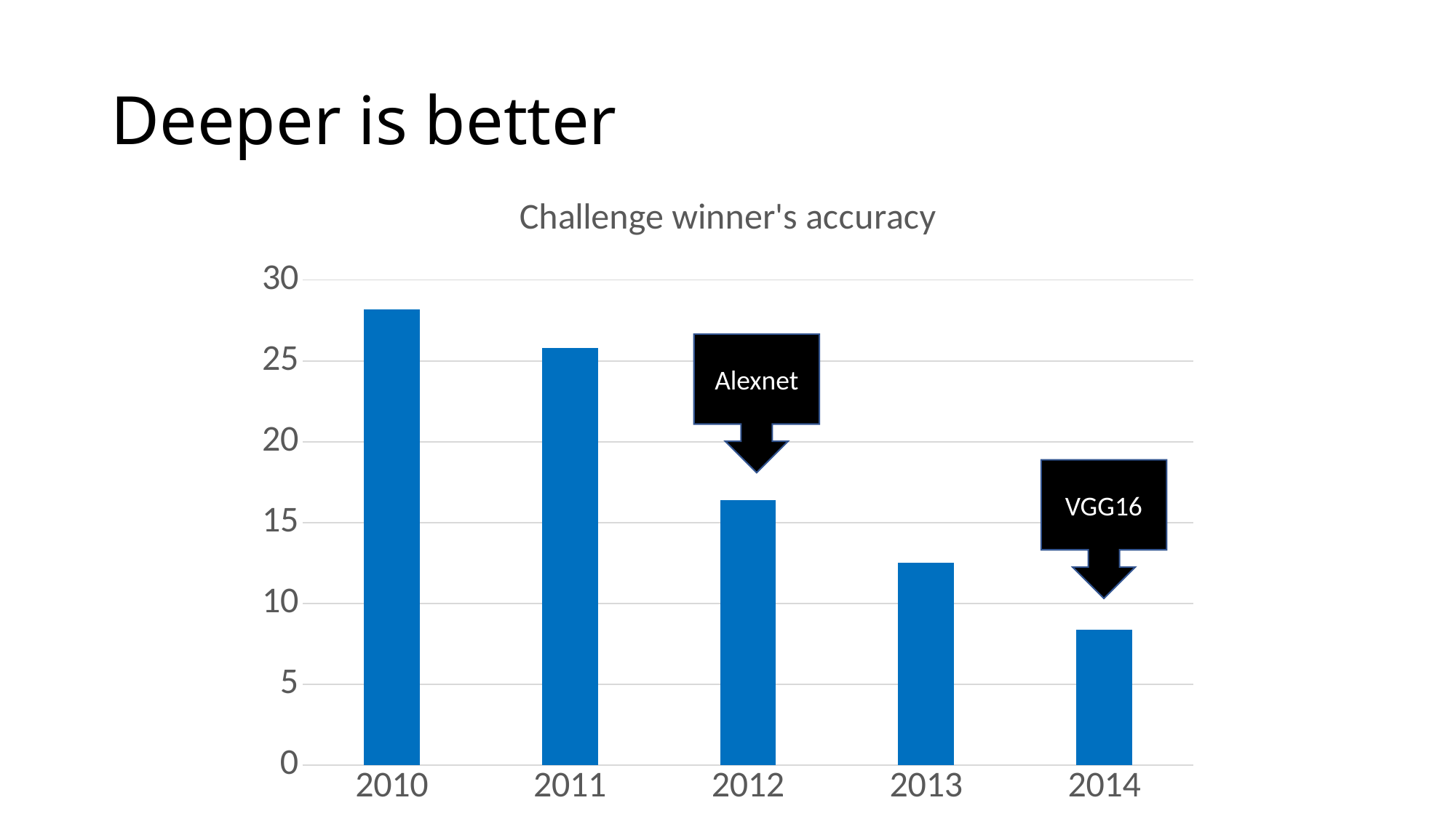
Is the value for 2010 greater or less than 25? greater Which year has the lowest bar in the chart? 2014 What is the title of the chart? Challenge winner's accuracy Is the value for 2014 greater or less than 10? less Do the values rise or fall from 2010 to 2014? fall Is the value for 2012 greater or less than 20? less How many years are shown on the x axis of the chart? 5 Which year has the highest bar in the chart? 2010 What kind of chart is shown on the slide? bar chart Which year's bar is labelled with the annotation "Alexnet"? 2012 Which is larger, the value for 2011 or the value for 2012? 2011